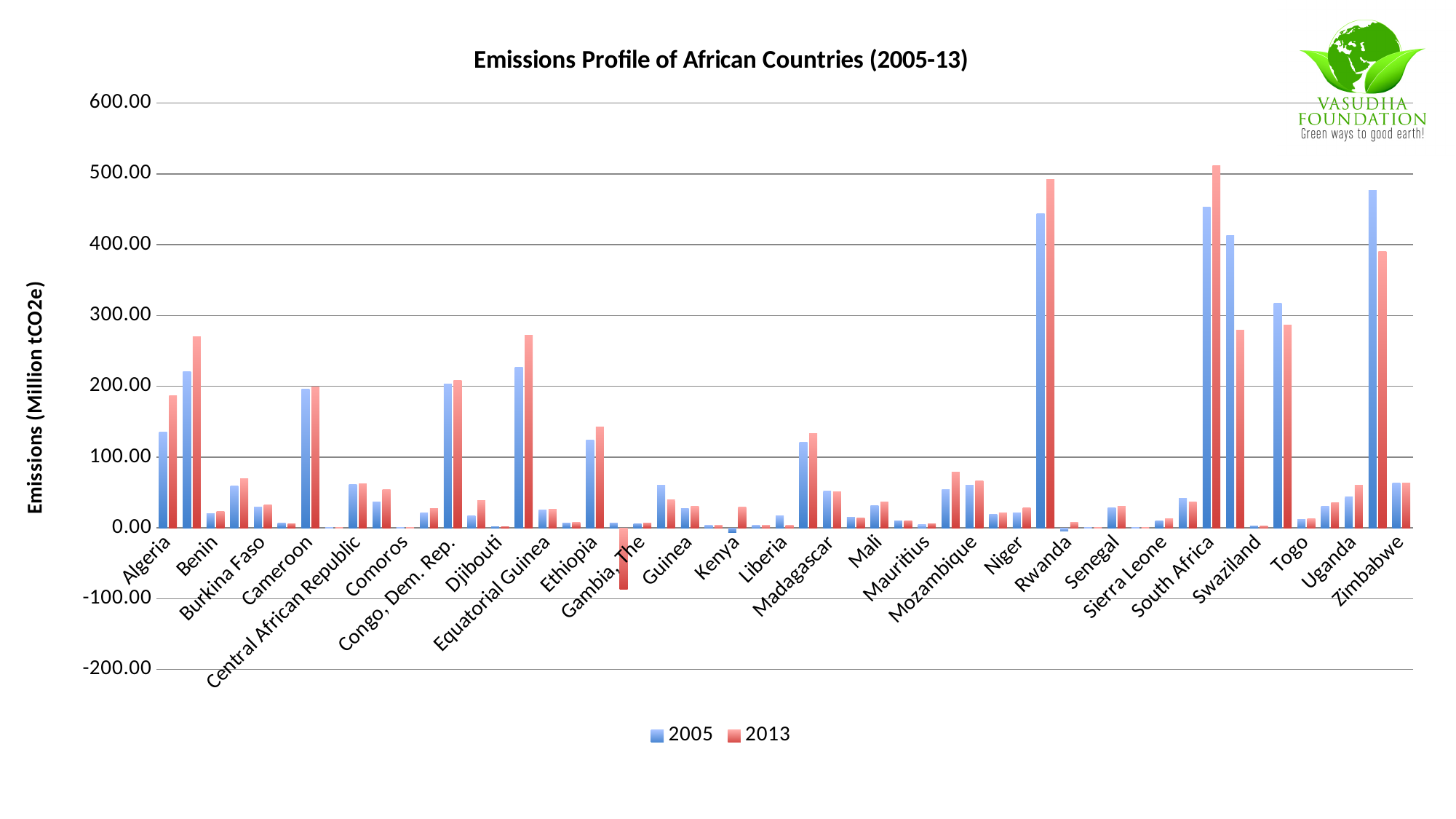
How many series does the legend list? 2 What is the lowest value shown on the vertical axis? -200.00 What is the title of the chart? Emissions Profile of African Countries (2005-13) Is the 2005 value for South Africa greater or less than 400.00? greater For South Africa, which is larger, the 2005 value or the 2013 value? 2013 Which series has a bar that falls below zero? Both 2005 and 2013 What kind of chart is shown on the slide? bar chart Which country has the highest 2013 emissions bar? South Africa Is the 2013 value for South Africa greater or less than 500.00? greater